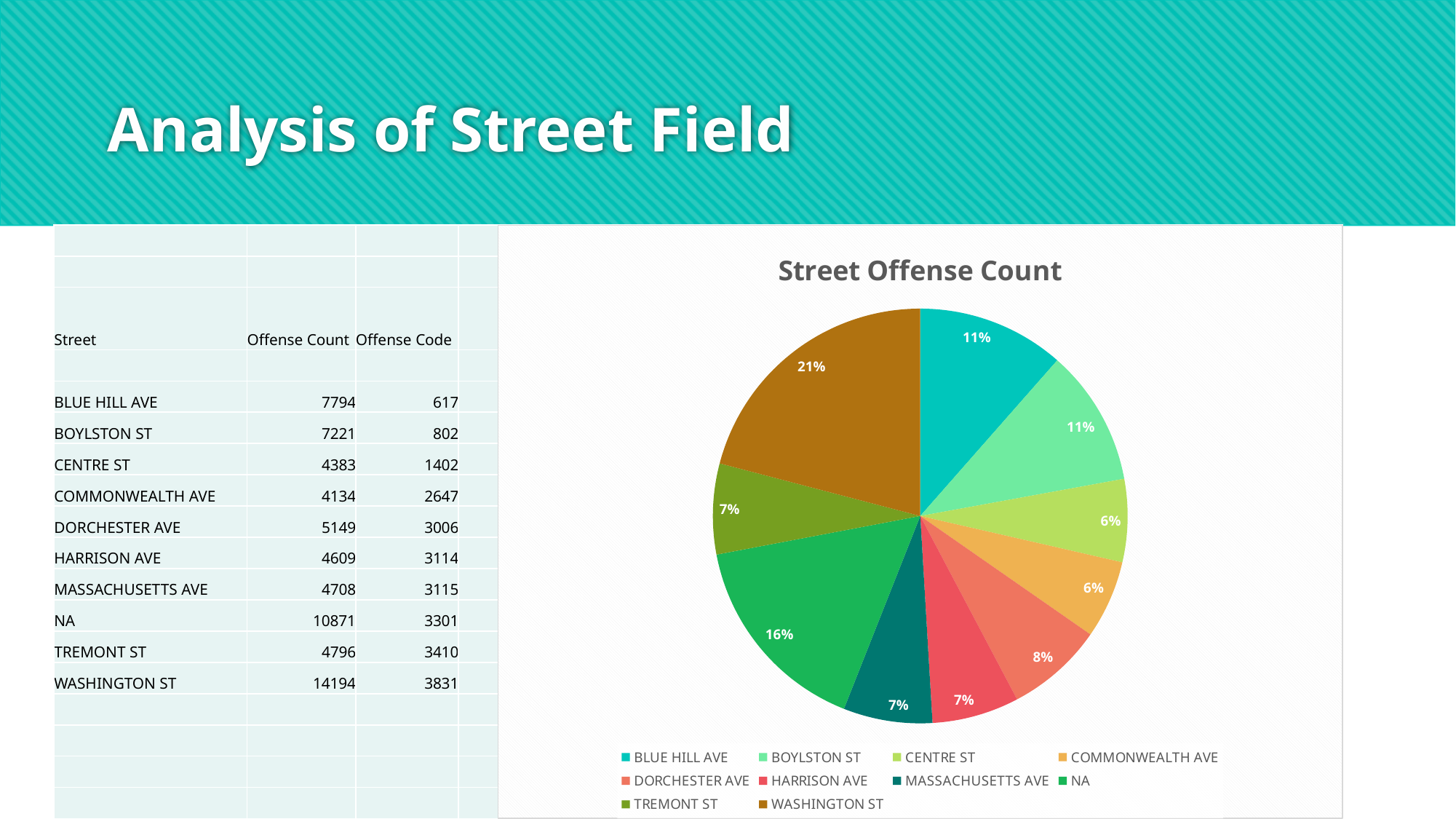
What is the title of the chart? Street Offense Count What share of the pie does WASHINGTON ST have? 21% What share of the pie does BLUE HILL AVE have? 11% What share of the pie does DORCHESTER AVE have? 8% How many slices does the pie chart have? 10 Which street has the largest slice of the pie? WASHINGTON ST Which slice is larger, WASHINGTON ST or NA? WASHINGTON ST What is the difference in percentage points between the WASHINGTON ST slice and the NA slice? 5% What kind of chart is shown on the slide? pie chart How many entries does the legend list? 10